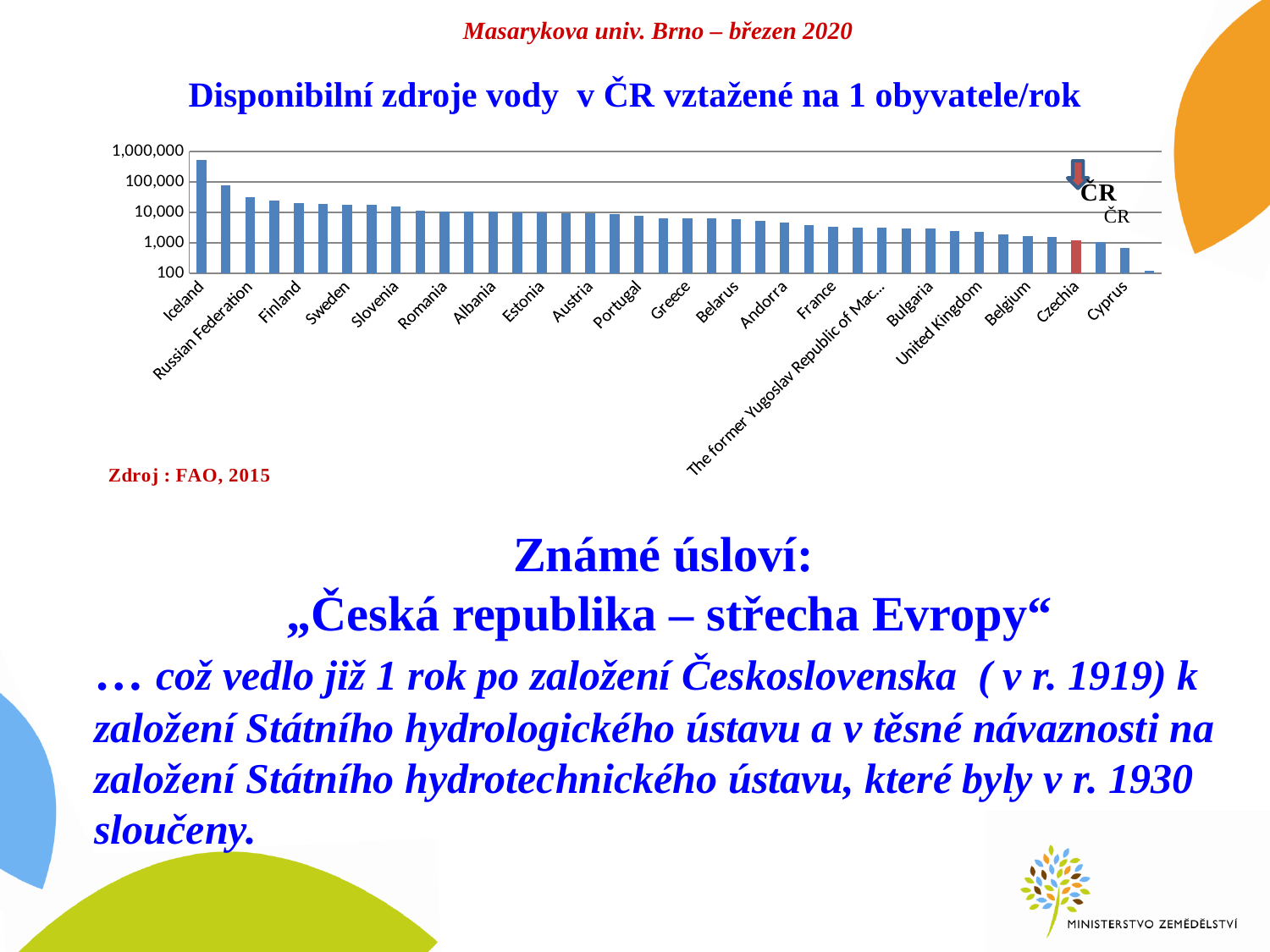
Is the value for Iceland greater or less than 100,000? greater Which has a larger value, Iceland or Czechia? Iceland Is the value for Finland greater or less than 10,000? greater Is the value for Czechia greater or less than 10,000? less Which has a larger value, Finland or Cyprus? Finland Do the values rise or fall moving from left to right along the x axis? fall What is the highest value shown on the vertical axis? 1,000,000 Which country's bar is highlighted in red? Czechia Which country has the highest value in the chart? Iceland What kind of chart is shown on the slide? bar chart